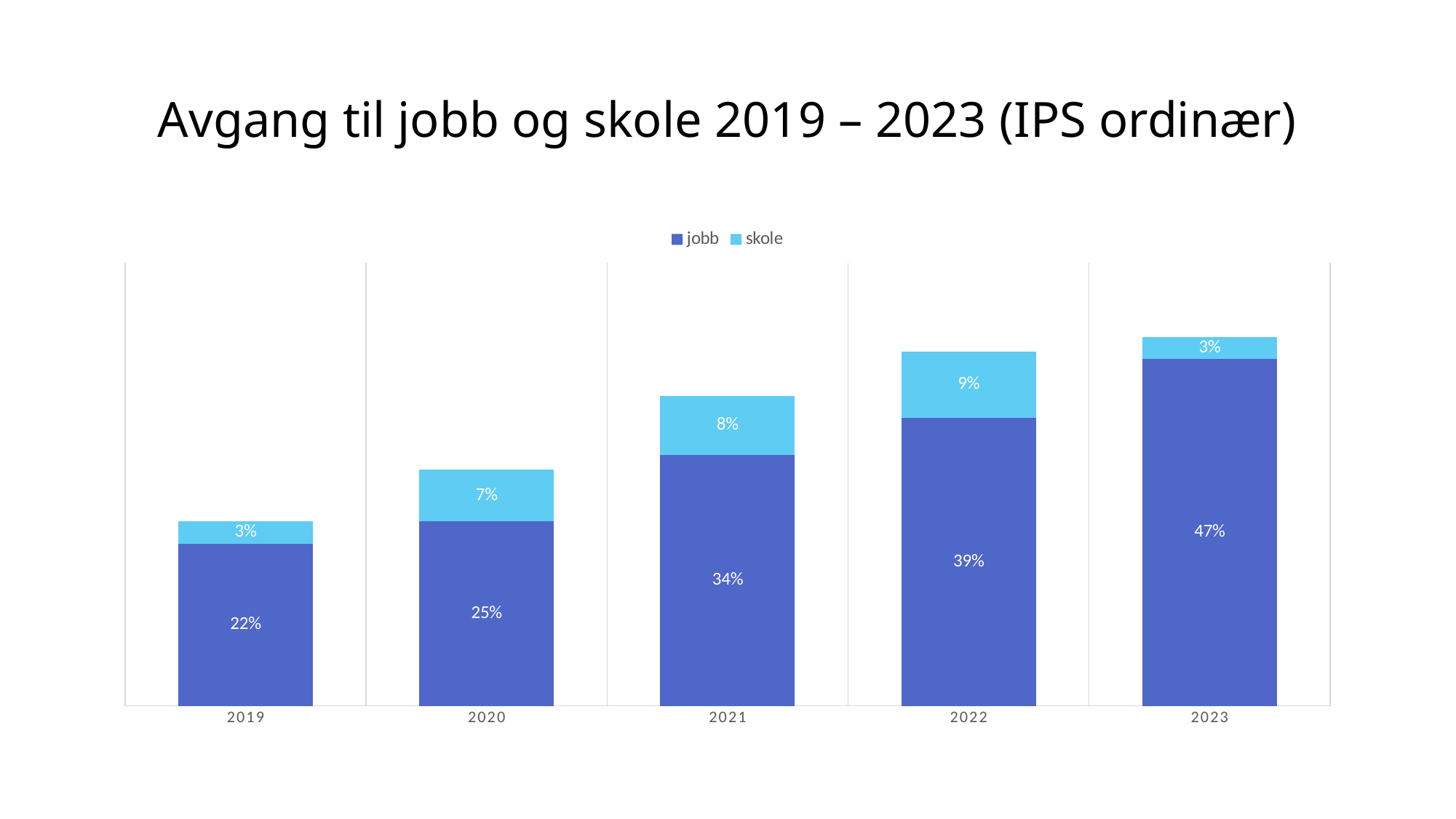
Is the skole value for 2020 larger or smaller than the skole value for 2021? smaller What is the value for jobb in 2021? 34% How many series does the legend list? 2 What is the difference between the jobb values for 2023 and 2019? 25% How many years are shown on the x axis? 5 What is the total of the stacked bar for 2022? 48% Which year has the highest value for jobb? 2023 What is the value for skole in 2022? 9% Which year has the lowest value for skole? 2019 and 2023 What is the value for jobb in 2019? 22% What kind of chart is shown? stacked bar chart Does the jobb value rise or fall from 2019 to 2023? rise